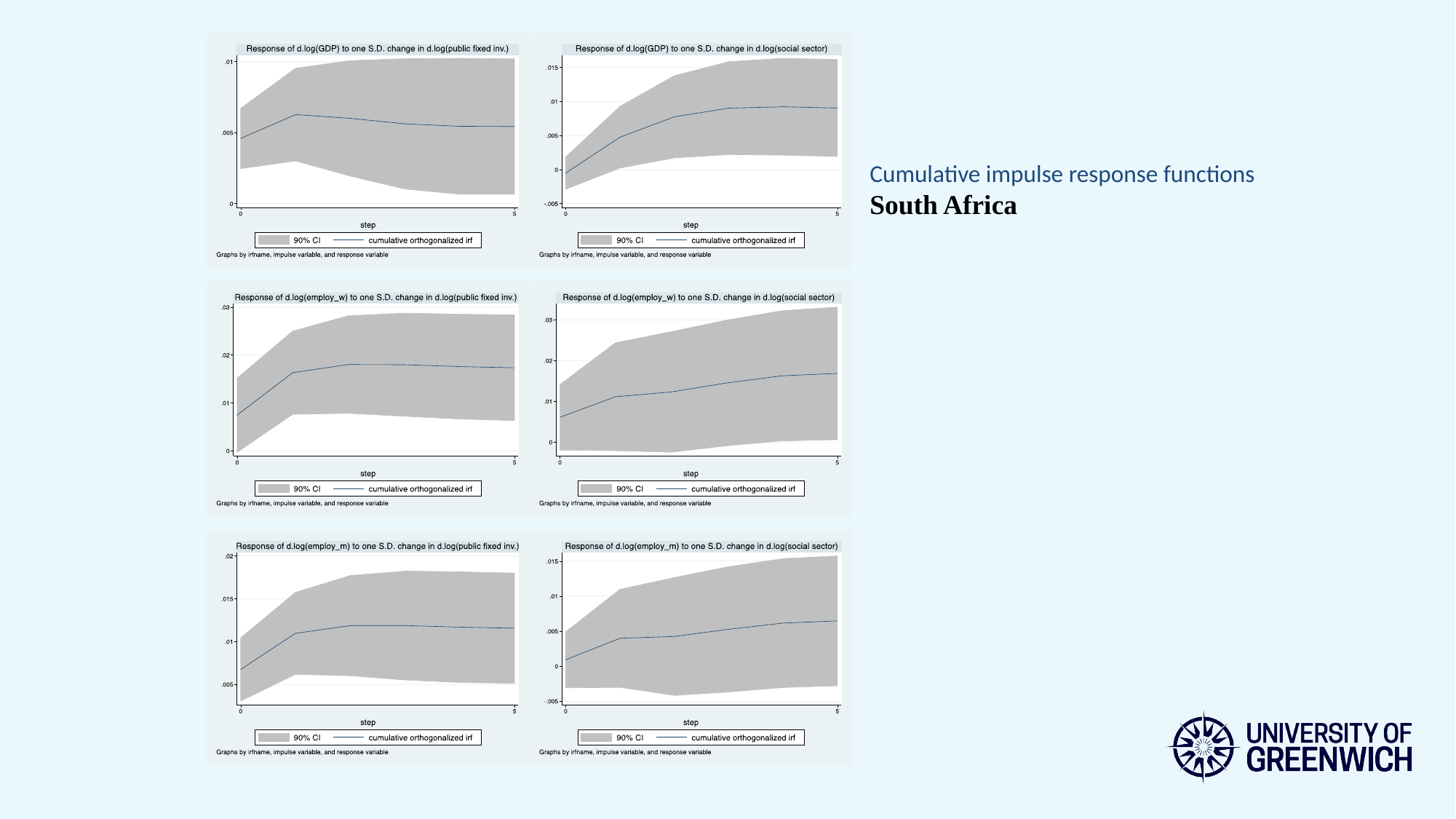
What kind of chart is the top-left chart, 'Response of d.log(GDP) to one S.D. change in d.log(public fixed inv.)'? line chart In the middle-left chart, 'Response of d.log(employ_w) to one S.D. change in d.log(public fixed inv.)', is the cumulative orthogonalized irf value at step 5 greater or less than .01? greater In the middle-right chart, 'Response of d.log(employ_w) to one S.D. change in d.log(social sector)', does the cumulative orthogonalized irf line rise or fall from step 0 to step 5? rise In the top-right chart, 'Response of d.log(GDP) to one S.D. change in d.log(social sector)', is the cumulative orthogonalized irf value at step 5 greater or less than .005? greater What is the label on the x axis of the middle-left chart, 'Response of d.log(employ_w) to one S.D. change in d.log(public fixed inv.)'? step In the top-left chart, 'Response of d.log(GDP) to one S.D. change in d.log(public fixed inv.)', is the cumulative orthogonalized irf value at step 5 greater or less than .01? less How many entries does the legend list in the top-right chart, 'Response of d.log(GDP) to one S.D. change in d.log(social sector)'? 2 In the top-right chart, 'Response of d.log(GDP) to one S.D. change in d.log(social sector)', does the cumulative orthogonalized irf line rise or fall from step 0 to step 5? rise In the bottom-right chart, 'Response of d.log(employ_m) to one S.D. change in d.log(social sector)', does the cumulative orthogonalized irf line rise or fall from step 0 to step 5? rise What are the two legend entries shown in the bottom-left chart, 'Response of d.log(employ_m) to one S.D. change in d.log(public fixed inv.)'? 90% CI and cumulative orthogonalized irf